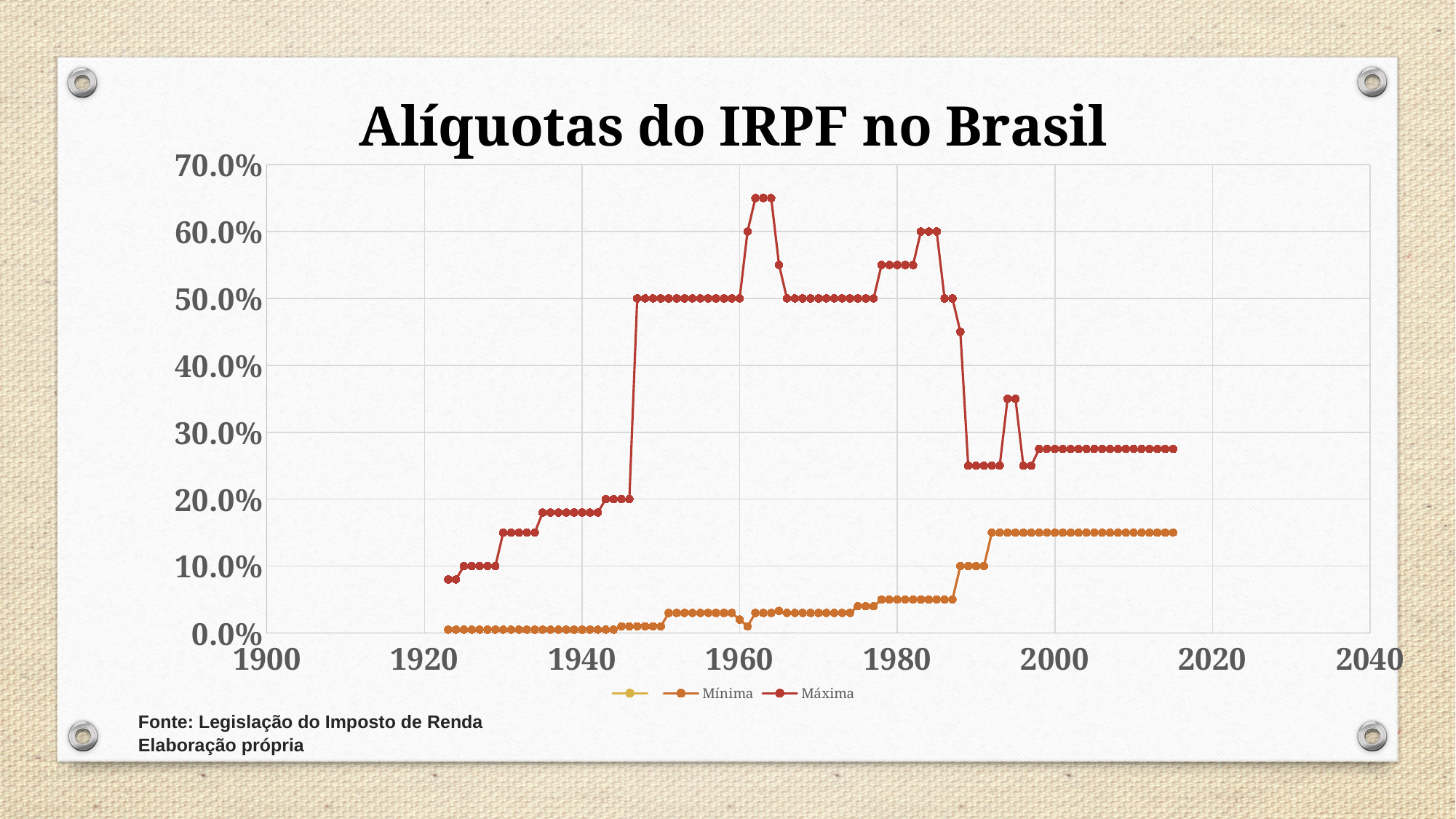
What is the difference between the Máxima value in 1955 (50.0%) and the Máxima value in 1946 (20.0%)? 30.0 percentage points Is the value of the Máxima series in 1963 greater or less than 60.0%? greater What is the title of the chart? Alíquotas do IRPF no Brasil Is the value of the Máxima series in 2010 greater or less than 30.0%? less Which two series are named in the chart legend? Mínima and Máxima What kind of chart is shown on the slide? line chart What is the value of the Máxima series in 1955? 50.0% What is the value of the Mínima series in 1990? 10.0% Is the value of the Mínima series in 2010 greater or less than 10.0%? greater Which series has the higher values throughout the chart, Mínima or Máxima? Máxima What is the value of the Máxima series in 1985? 60.0%